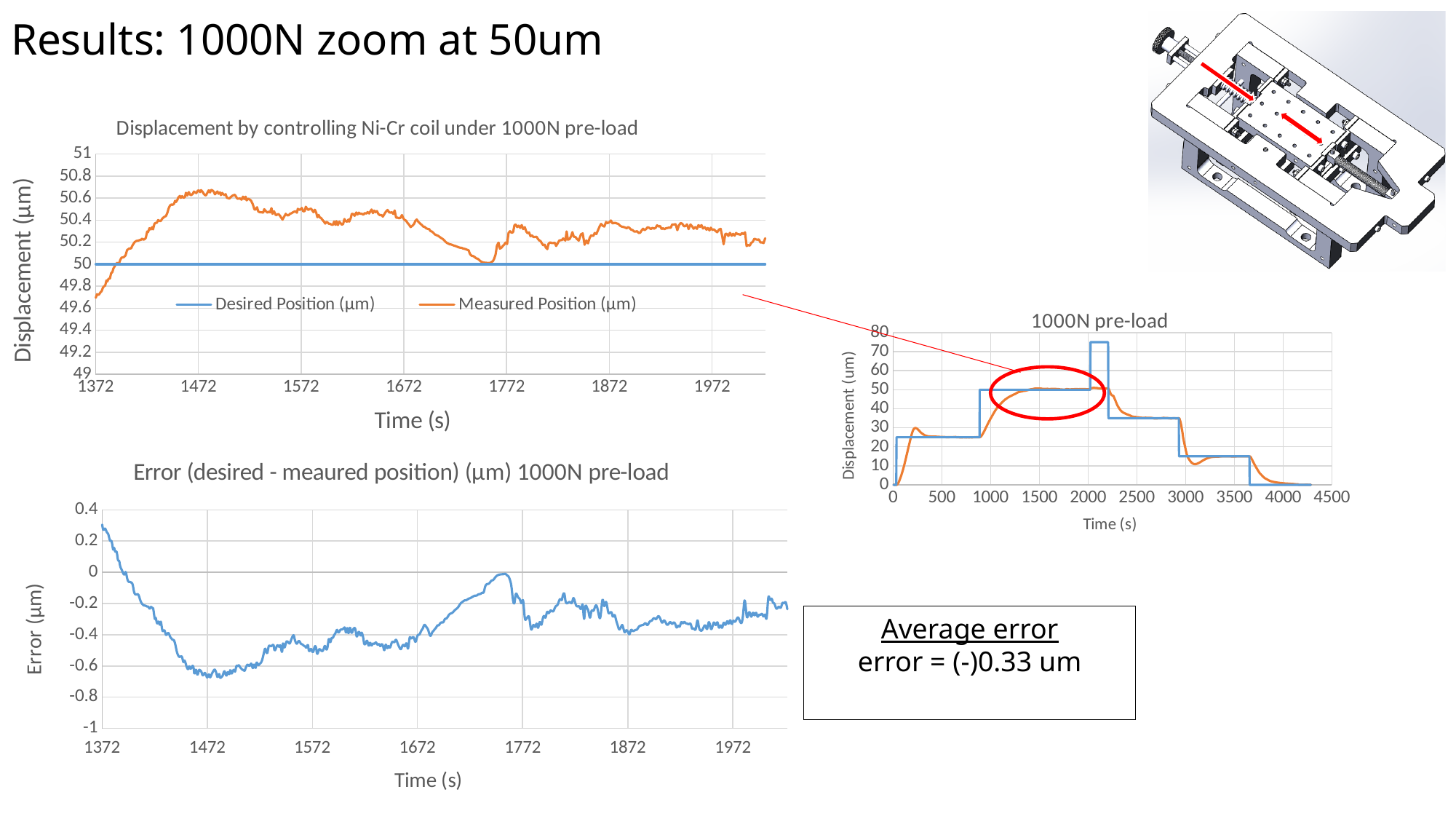
In the bottom-left error chart, is the error at time 1372 greater or less than 0.2? greater In the bottom-left error chart, does the error rise or fall between time 1372 and time 1472? fall In the top-left displacement chart, what is the value of the Desired Position (µm) series? 50 In the bottom-left error chart, is the error at time 1472 greater or less than -0.6? less In the top-left displacement chart, is the Measured Position higher at time 1472 or at time 1772? 1472 In the top-left displacement chart, is the Measured Position at time 1372 greater or less than 50? less In the right-hand chart titled '1000N pre-load', what is the desired (blue) displacement at time 1500? 50 What is the x-axis label of the top-left displacement chart? Time (s) How many series does the legend of the top-left displacement chart list? 2 What kind of chart is the top-left chart titled 'Displacement by controlling Ni-Cr coil under 1000N pre-load'? Line chart